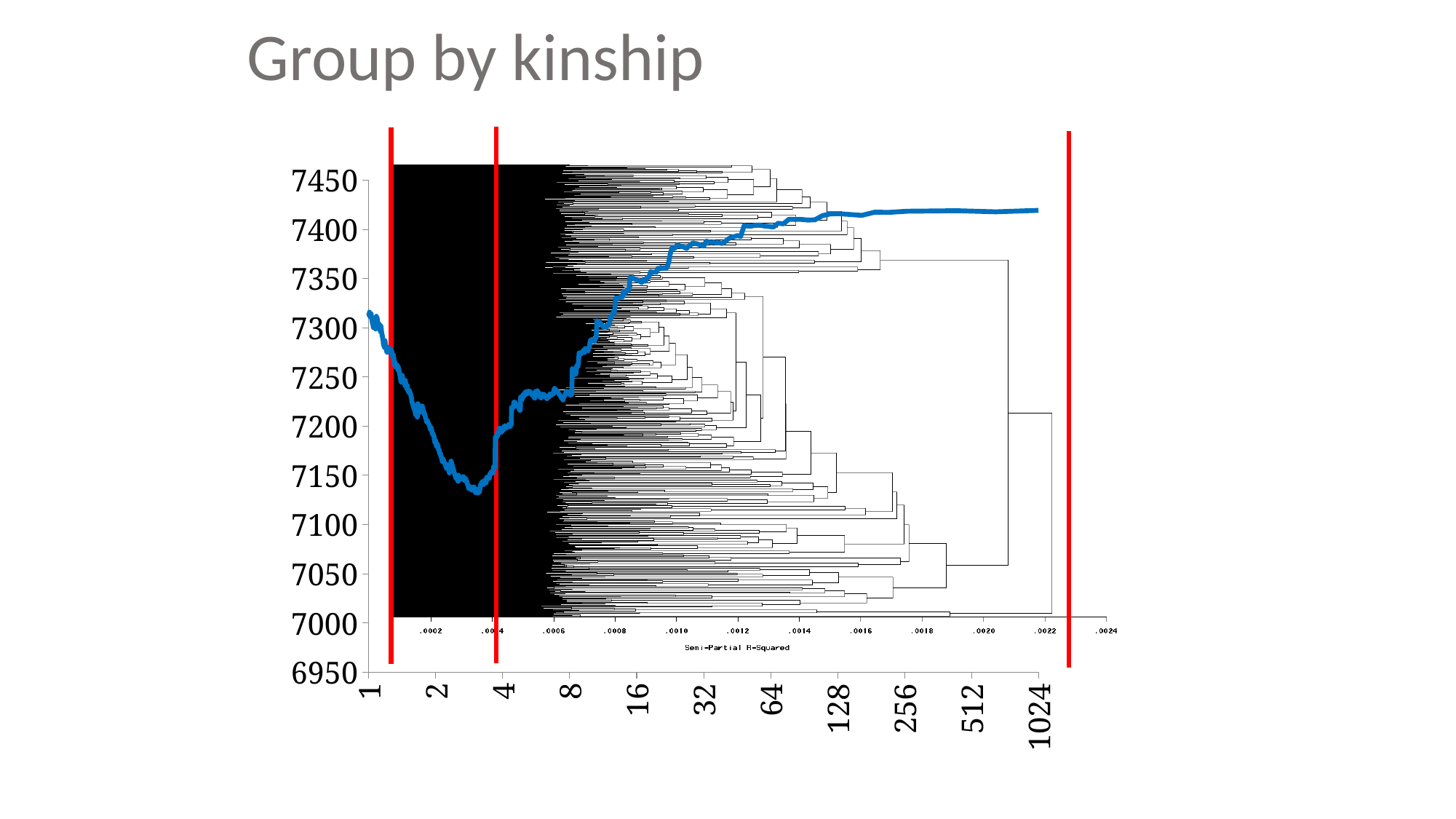
Is the value of the blue line at x = 2 greater or less than 7250? less Is the value of the blue line higher at x = 1024 or at x = 1? x = 1024 Does the blue line rise or fall between x = 1 and x = 4? fall Is the lowest point of the blue line greater or less than 7100? greater What is the title of the slide containing the chart? Group by kinship What kind of chart is the blue plotted series on the slide? line chart How many tick labels are shown on the x axis of the chart? 11 Is the value of the blue line at x = 8 greater or less than 7300? less What is the highest tick label on the y axis of the chart? 7450